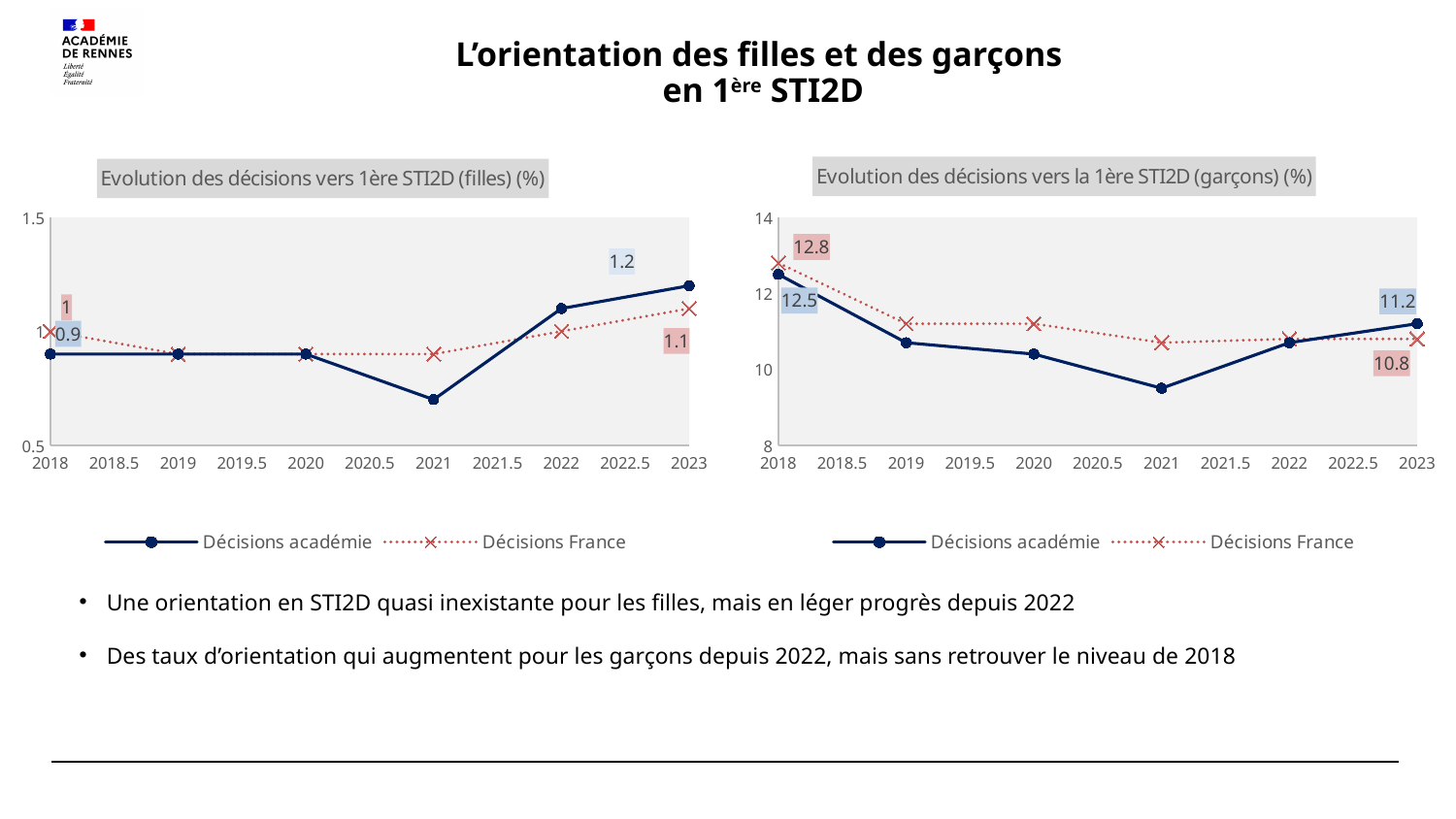
In the chart 'Evolution des décisions vers la 1ère STI2D (garçons) (%)', in which year is the Décisions académie value highest? 2018 In the chart 'Evolution des décisions vers la 1ère STI2D (garçons) (%)', what is the value for Décisions académie in 2018? 12.5 In the chart 'Evolution des décisions vers la 1ère STI2D (garçons) (%)', what is the value for Décisions France in 2023? 10.8 In the chart 'Evolution des décisions vers la 1ère STI2D (garçons) (%)', is the value for Décisions académie in 2021 greater or less than 10? less In the chart 'Evolution des décisions vers la 1ère STI2D (garçons) (%)', does the Décisions académie series rise or fall between 2021 and 2023? Rise In the chart 'Evolution des décisions vers 1ère STI2D (filles) (%)', what is the value for Décisions académie in 2023? 1.2 In the chart 'Evolution des décisions vers la 1ère STI2D (garçons) (%)', what is the difference between Décisions France and Décisions académie in 2018? 0.3 In the chart 'Evolution des décisions vers 1ère STI2D (filles) (%)', which series has the higher value in 2023, Décisions académie or Décisions France? Décisions académie What kind of chart is 'Evolution des décisions vers 1ère STI2D (filles) (%)'? Line chart In the chart 'Evolution des décisions vers 1ère STI2D (filles) (%)', what is the value for Décisions France in 2018? 1 How many series does the legend of the chart 'Evolution des décisions vers la 1ère STI2D (garçons) (%)' list? 2 In the chart 'Evolution des décisions vers 1ère STI2D (filles) (%)', in which year is the Décisions académie value lowest? 2021